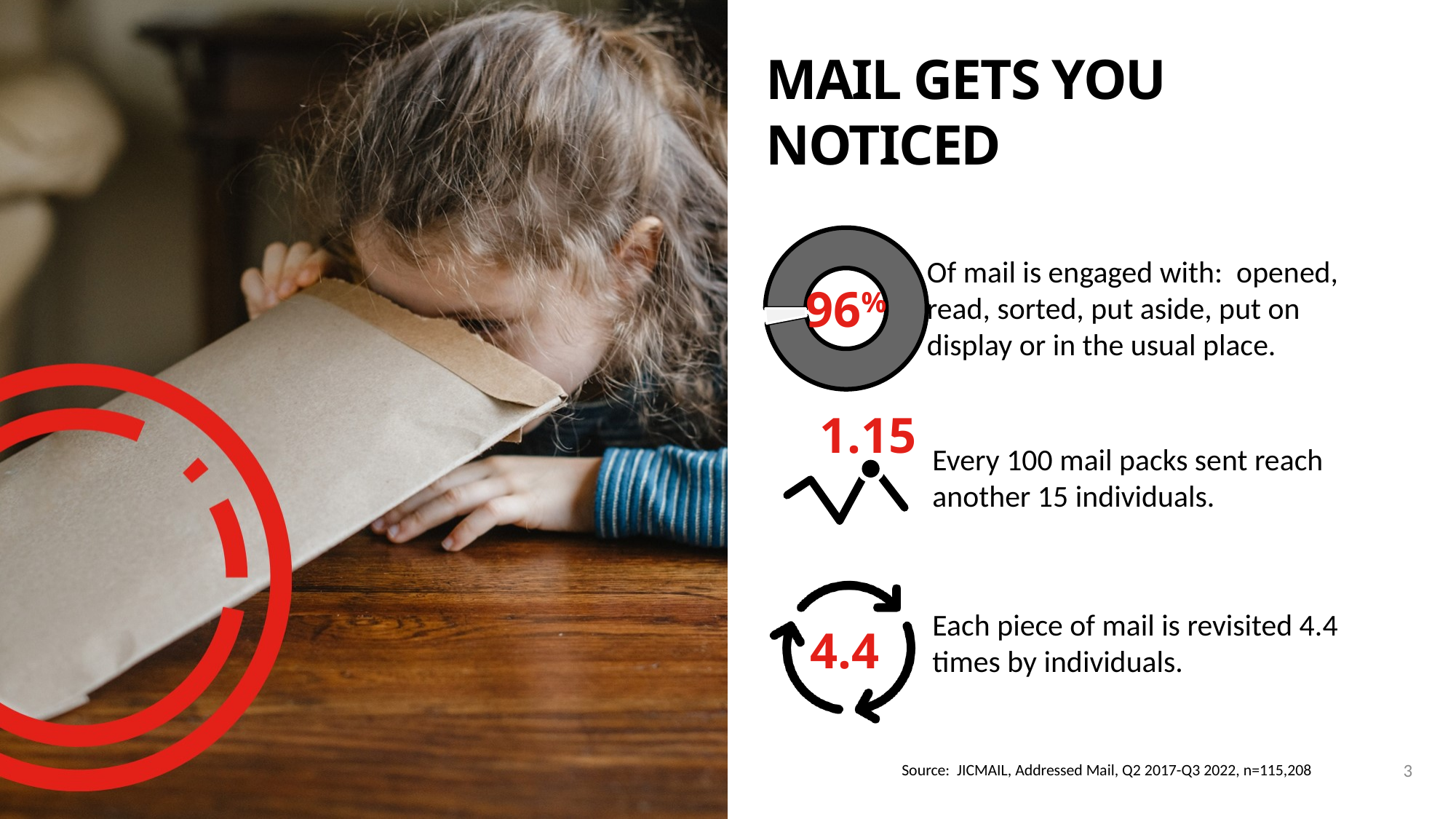
How many segments does the donut chart have? 2 What kind of chart is shown next to the text 'Of mail is engaged with'? Donut (pie) chart Which segment of the donut chart is larger, the grey one or the white one? The grey one What percentage is printed in the centre of the donut chart? 96% What colour is the large segment of the donut chart? Grey What does the 96% in the donut chart represent, according to the text beside it? Mail that is engaged with: opened, read, sorted, put aside, put on display or in the usual place